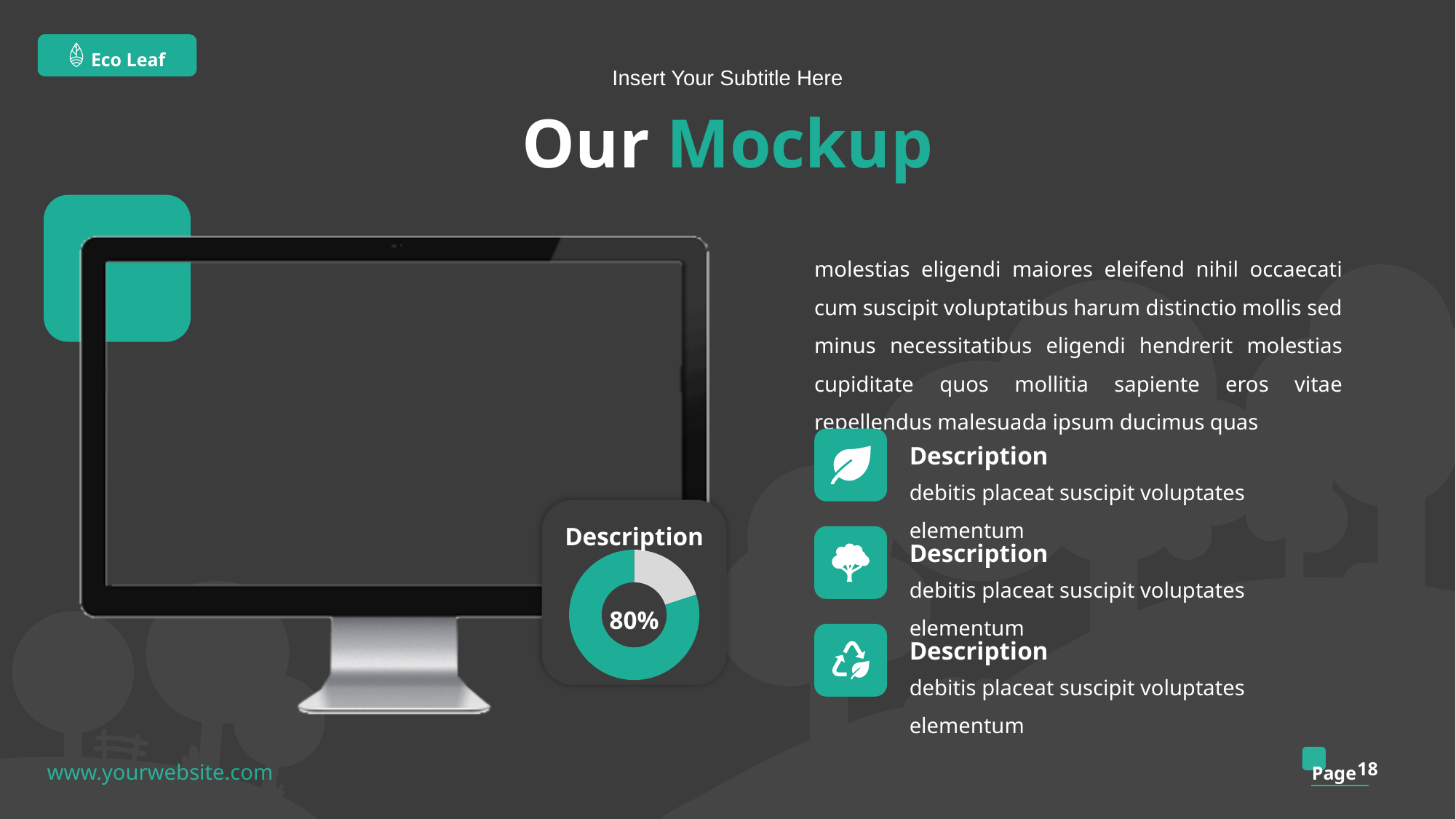
How many segments does the doughnut chart have? 2 What colour is the larger segment of the doughnut chart? Teal What value is printed in the centre of the doughnut chart? 80% What kind of chart is shown on the slide? Doughnut chart What share of the doughnut chart does the grey segment represent? 20% Is the value shown in the doughnut chart greater or less than 50%? greater What share of the doughnut chart does the teal segment represent? 80% Which segment of the doughnut chart is larger, the teal one or the grey one? Teal What is the title printed above the doughnut chart? Description